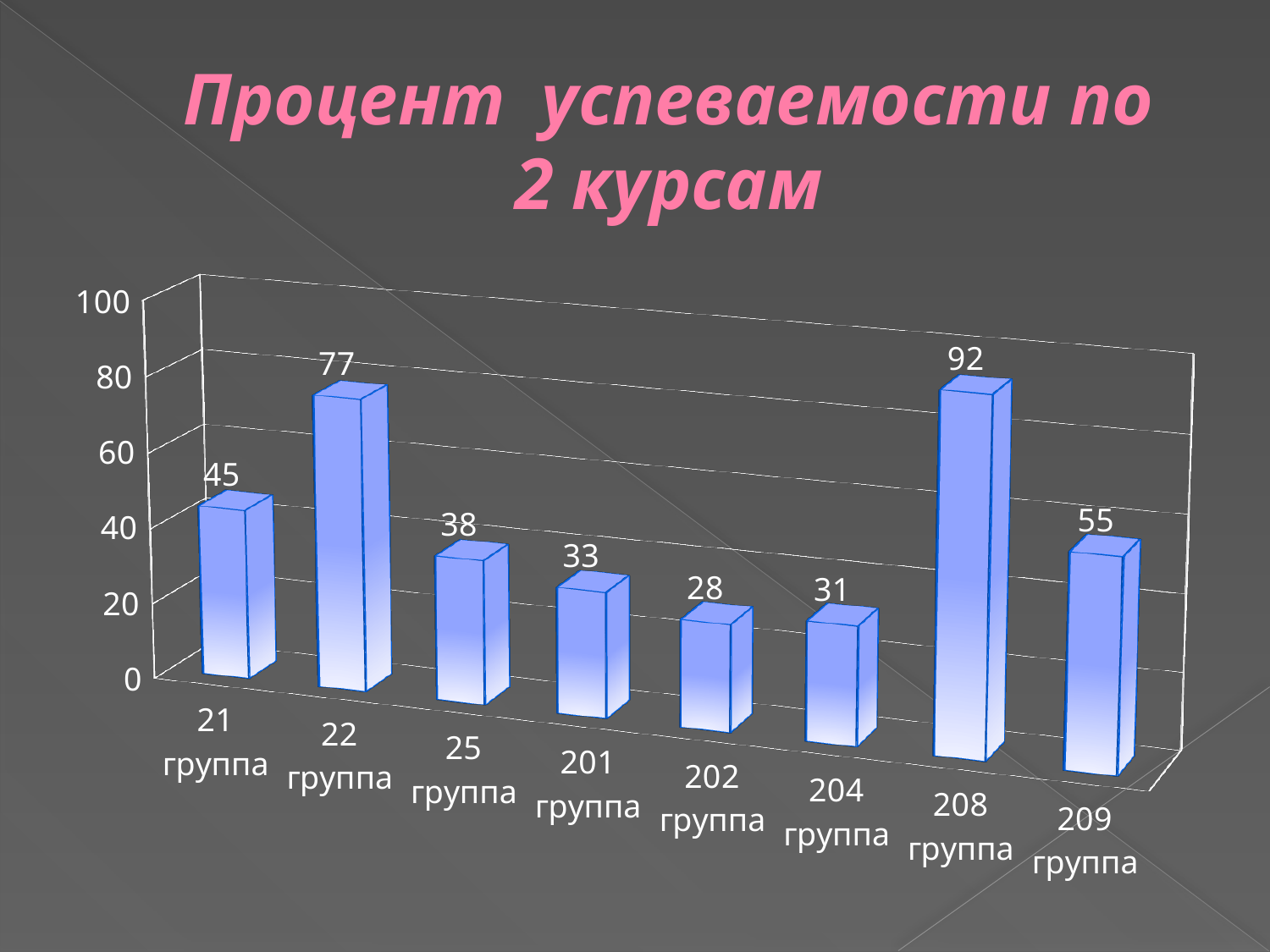
Which is larger, the value for 201 группа or the value for 209 группа? 209 группа What is the value for 22 группа? 77 Is the value for 208 группа greater or less than 80? greater What is the difference between the values for 208 группа and 22 группа? 15 What kind of chart is shown on the slide? bar chart Which group has the lowest value? 202 группа What is the title of the chart on the slide? Процент успеваемости по 2 курсам What is the value for 209 группа? 55 What is the difference between the values for 21 группа and 25 группа? 7 How many groups are shown on the chart? 8 What is the value for 204 группа? 31 Which group has the highest value? 208 группа